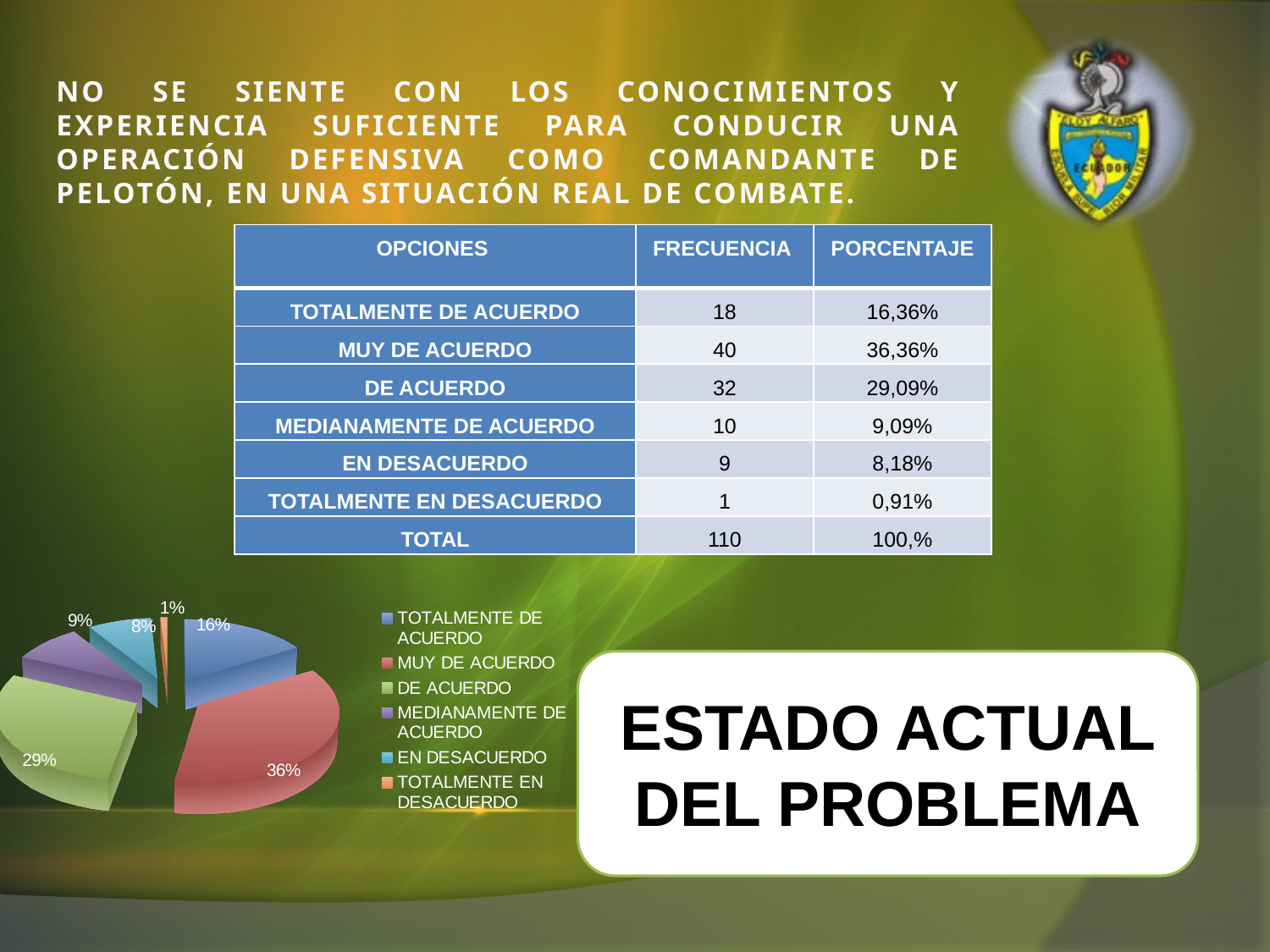
Which category has the largest slice in the pie chart? MUY DE ACUERDO How many slices does the pie chart have? 6 What is the data label for TOTALMENTE EN DESACUERDO in the pie chart? 1% What share of the pie chart does MUY DE ACUERDO take? 36% What kind of chart is shown on the slide? pie chart What is the data label for DE ACUERDO in the pie chart? 29% Which category has the smallest slice in the pie chart? TOTALMENTE EN DESACUERDO What colour is the MUY DE ACUERDO slice in the pie chart? red What is the data label for TOTALMENTE DE ACUERDO in the pie chart? 16% What is the difference between the MUY DE ACUERDO and DE ACUERDO slices in the pie chart? 7% Which slice is larger in the pie chart, MEDIANAMENTE DE ACUERDO or EN DESACUERDO? MEDIANAMENTE DE ACUERDO How many series does the legend of the pie chart list? 6